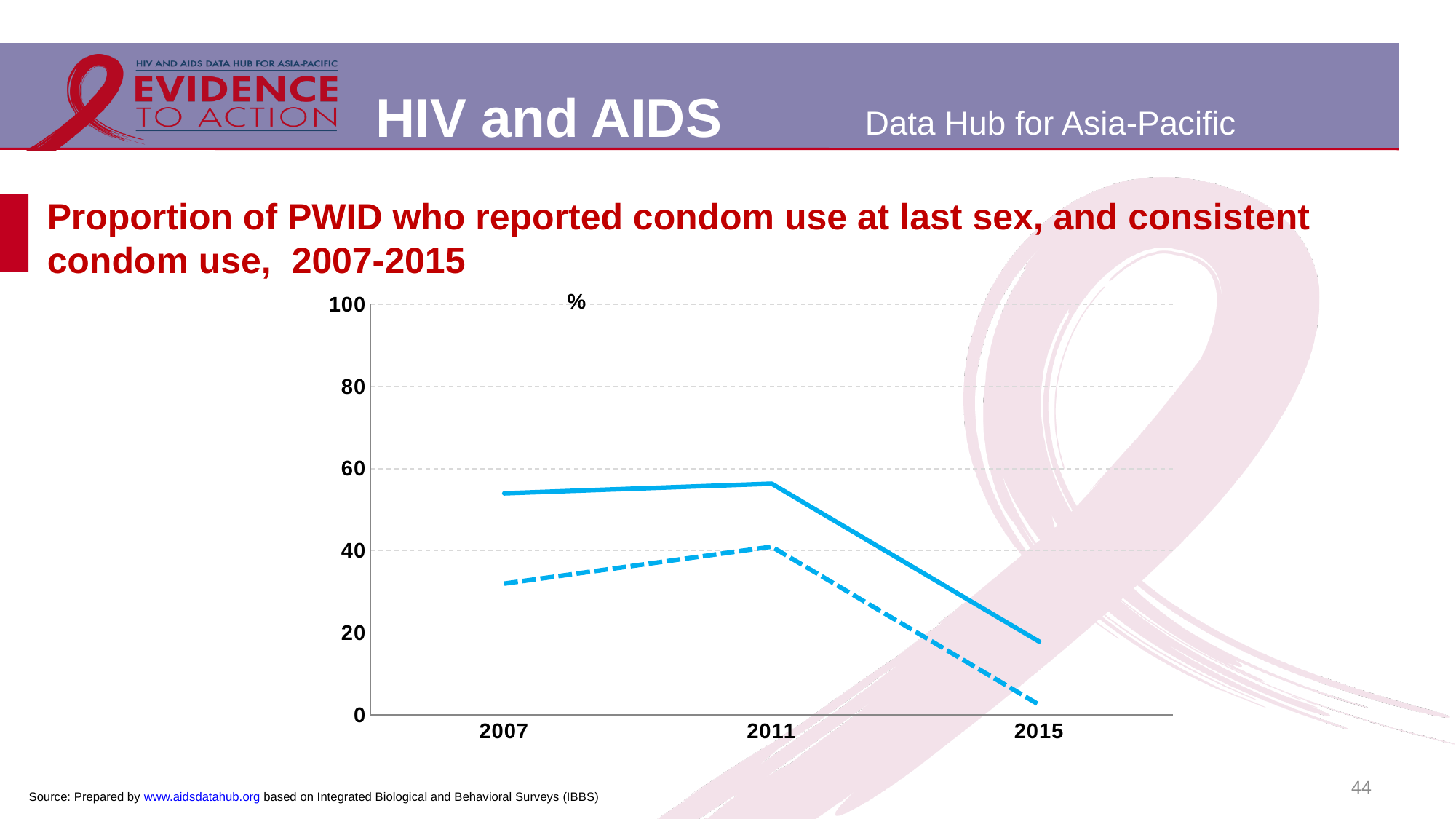
In which year does the dashed line reach its highest value? 2011 Which years are labelled on the x axis of the chart? 2007, 2011, 2015 How many years are labelled on the x axis of the chart? 3 Between 2011 and 2015, do the values of both lines rise or fall? fall What unit is shown at the top of the y axis of the chart? % What kind of chart is shown on the slide? line chart In 2011, which line has the larger value, the solid line or the dashed line? solid line Is the value of the solid line in 2007 greater or less than 40? greater Is the value of the dashed line in 2011 greater or less than 60? less In which year does the solid line reach its lowest value? 2015 Is the value of the dashed line in 2015 greater or less than 20? less